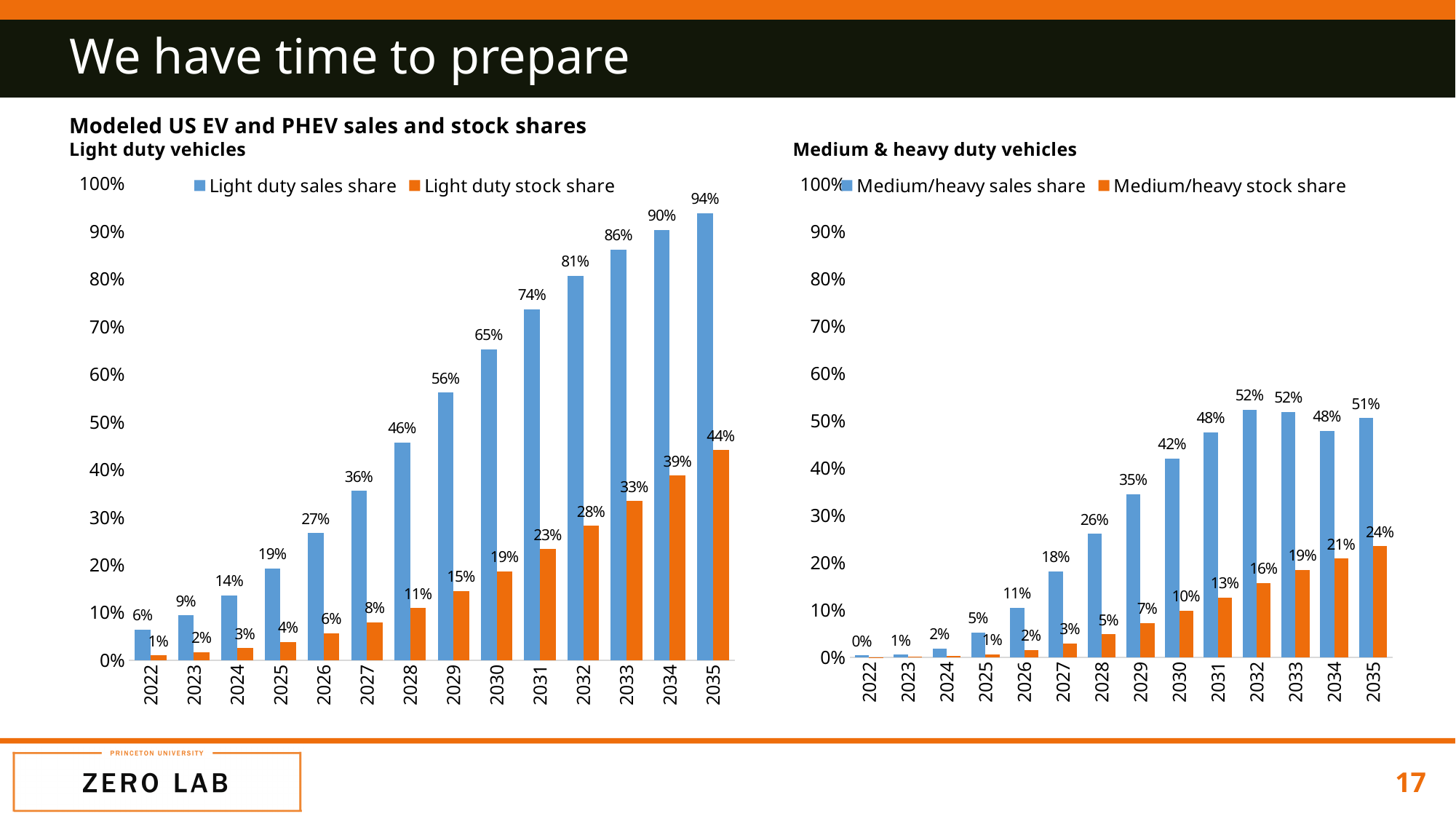
In the Light duty vehicles chart, which year has the highest light duty sales share? 2035 In the Light duty vehicles chart, does the light duty stock share rise or fall from 2022 to 2035? Rise How many series does the legend of the Medium & heavy duty vehicles chart list? 2 In the Light duty vehicles chart, what is the difference between the light duty sales share and the light duty stock share in 2032? 53% In the Medium & heavy duty vehicles chart, which year has the highest medium/heavy stock share? 2035 In the Medium & heavy duty vehicles chart, what is the medium/heavy stock share in 2033? 19% In the Medium & heavy duty vehicles chart, which is larger in 2031: the medium/heavy sales share or the medium/heavy stock share? Medium/heavy sales share In the Medium & heavy duty vehicles chart, what is the medium/heavy sales share in 2029? 35% How many years are shown on the x axis of the Light duty vehicles chart? 14 In the Light duty vehicles chart, what is the light duty sales share in 2030? 65% In the Light duty vehicles chart, what is the light duty stock share in 2035? 44% What kind of chart is the Light duty vehicles chart? Bar chart